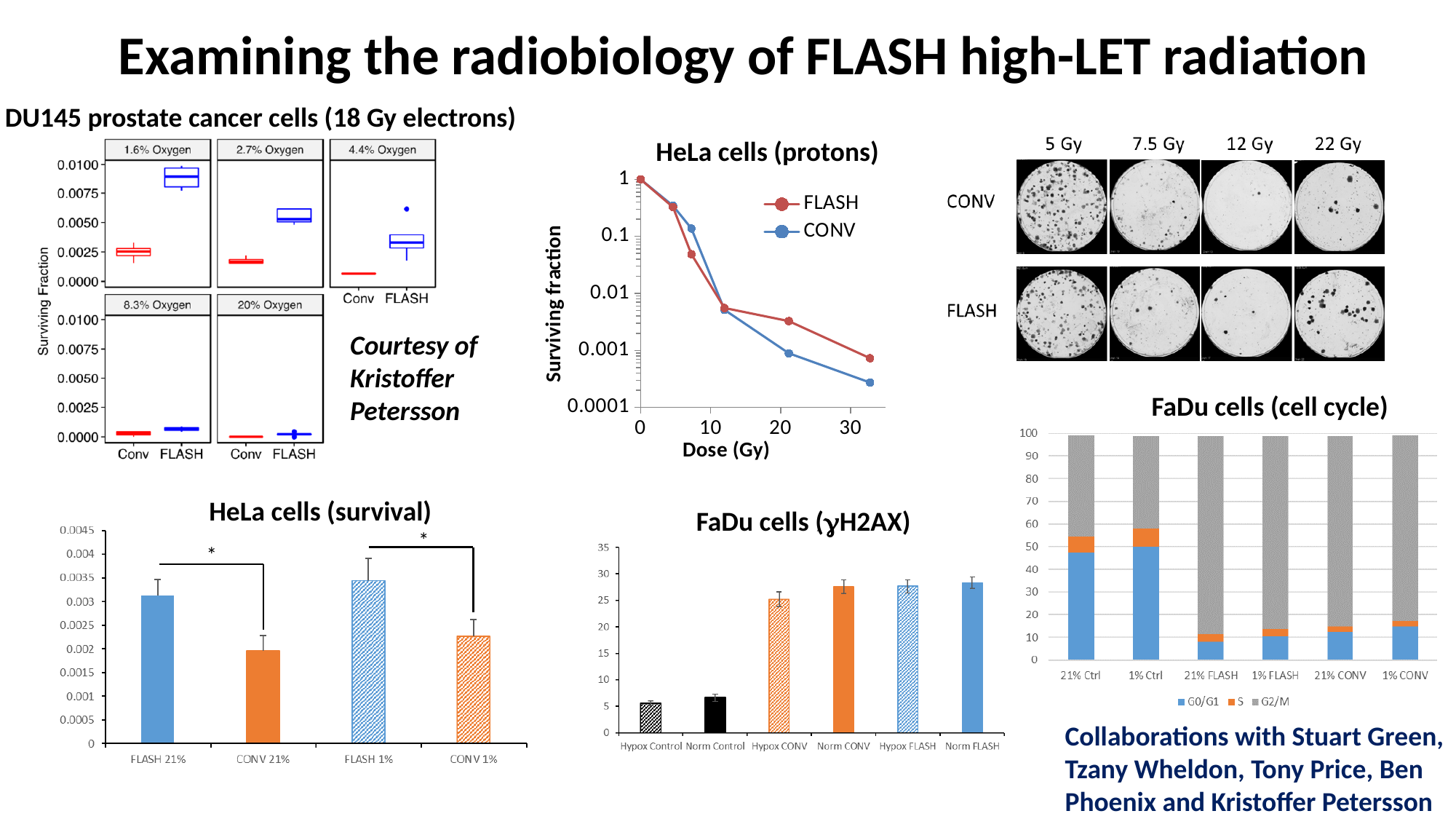
How many series does the legend of the FaDu cells (cell cycle) chart list? 3 In the HeLa cells (survival) chart, which category has the lowest bar? CONV 21% In the HeLa cells (survival) chart, which category has the highest bar? FLASH 1% In the HeLa cells (protons) chart, which series has the higher surviving fraction at the highest dose plotted, FLASH or CONV? FLASH How many bars are plotted in the HeLa cells (survival) chart? 4 In the HeLa cells (survival) chart, is the value for CONV 21% greater or less than 0.0025? less In the FaDu cells (γH2AX) chart, which category has the lowest bar? Hypox Control In the FaDu cells (γH2AX) chart, is the value for Hypox CONV greater or less than 20? greater In the HeLa cells (protons) chart, do the surviving fraction values rise or fall as dose increases? fall In the FaDu cells (cell cycle) chart, is the G0/G1 value for 21% FLASH greater or less than 10? less What kind of chart is the FaDu cells (cell cycle) chart? stacked bar chart In the FaDu cells (γH2AX) chart, which is larger, Norm Control or Norm CONV? Norm CONV